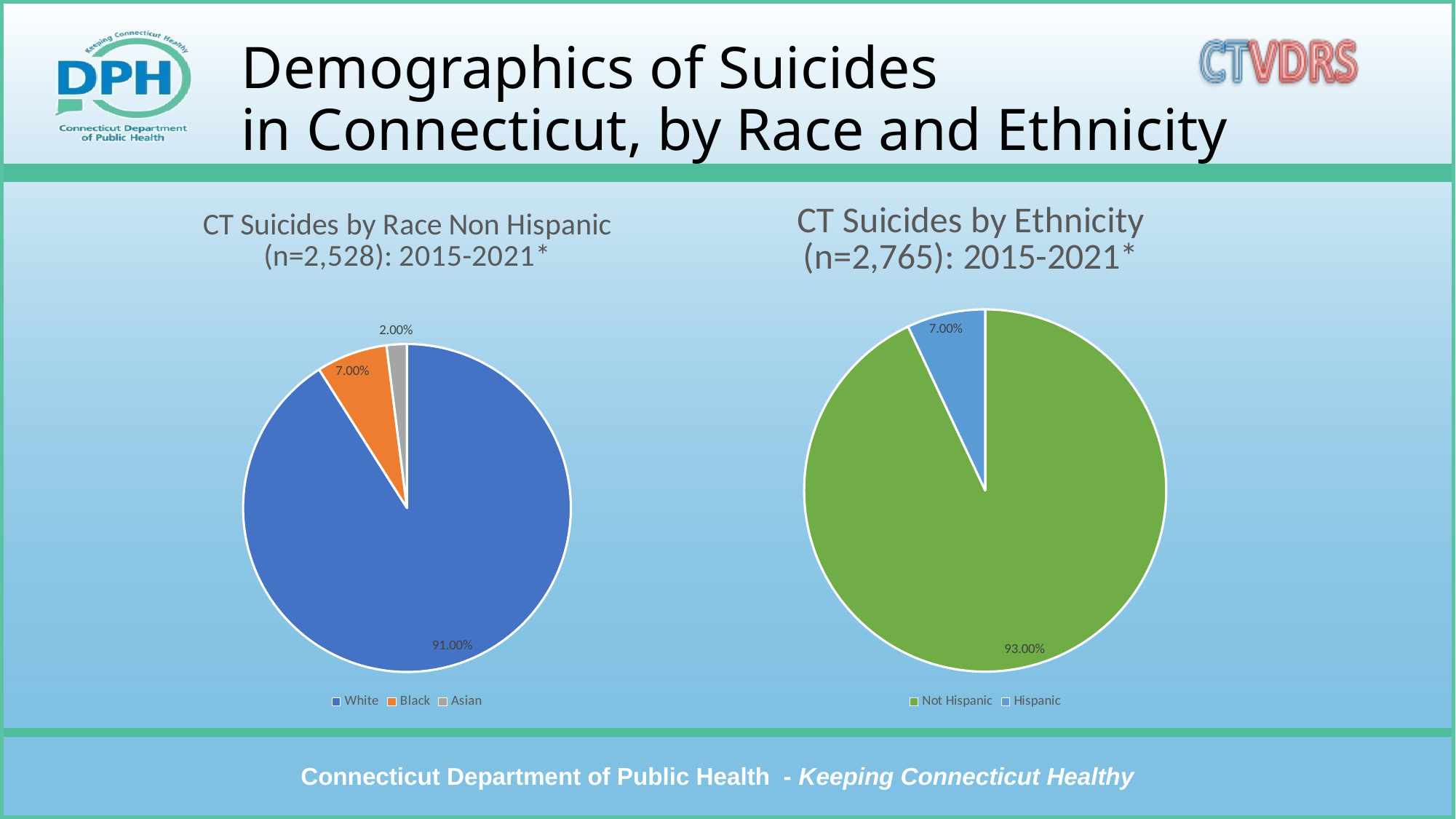
In the 'CT Suicides by Ethnicity' chart, what is the difference in percentage points between the Not Hispanic and Hispanic slices? 86.00% In the 'CT Suicides by Race Non Hispanic' chart, which category has the smallest slice? Asian In the 'CT Suicides by Race Non Hispanic' chart, what share of the pie is Asian? 2.00% In the 'CT Suicides by Race Non Hispanic' chart, what share of the pie is Black? 7.00% What kind of chart is the 'CT Suicides by Ethnicity' chart? Pie chart In the 'CT Suicides by Race Non Hispanic' chart, which category has the largest slice? White In the 'CT Suicides by Ethnicity' chart, what share of the pie is Not Hispanic? 93.00% In the 'CT Suicides by Race Non Hispanic' chart, what is the difference in percentage points between the Black and Asian slices? 5.00% How many categories does the 'CT Suicides by Race Non Hispanic' chart show? 3 What is the sample size (n) given in the title of the 'CT Suicides by Ethnicity' chart? 2,765